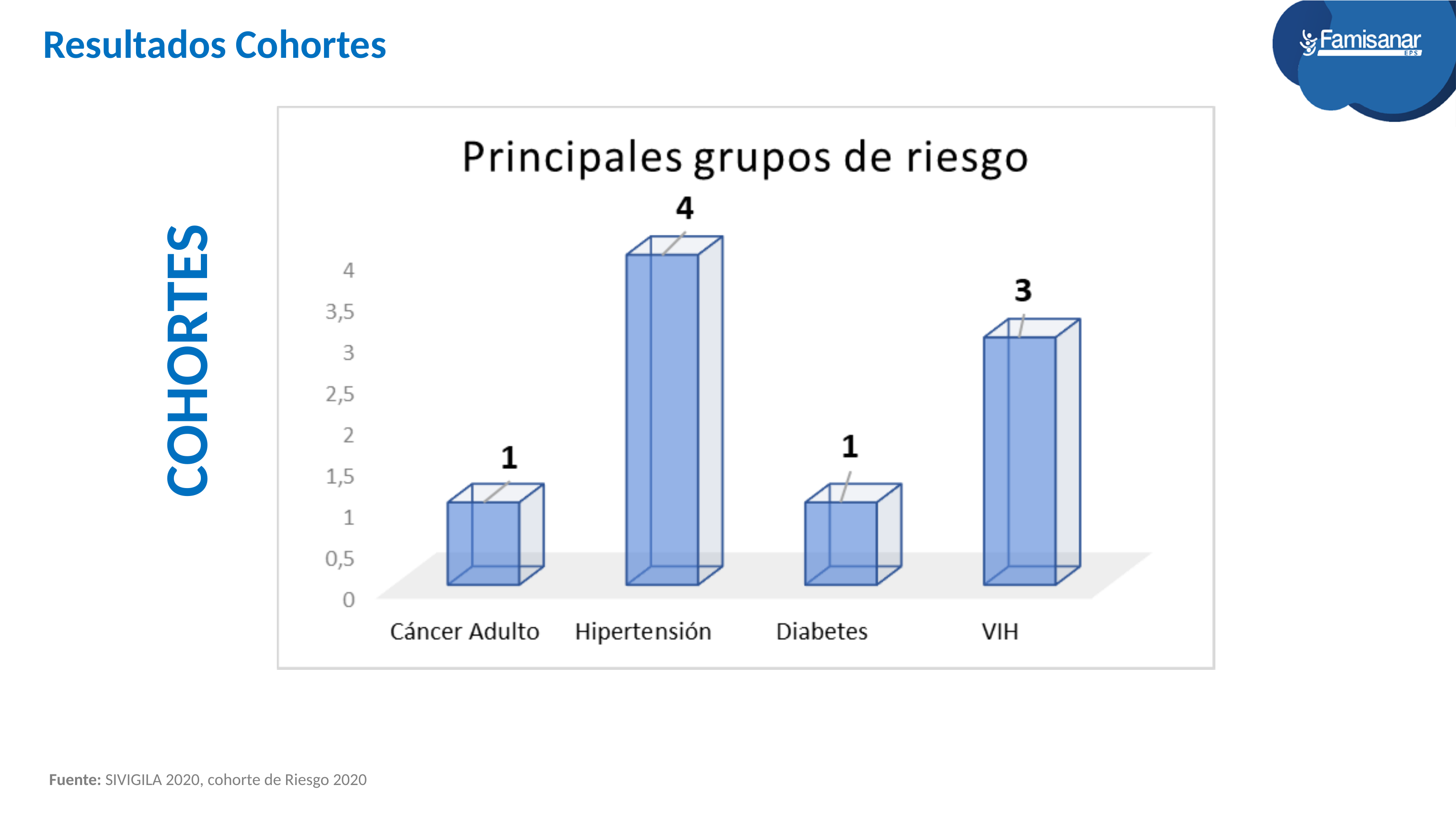
Is the value for Hipertensión greater or less than 3,5? greater How many categories are shown on the x axis? 4 What is the value for Cáncer Adulto? 1 What is the value for VIH? 3 What is the title of the chart? Principales grupos de riesgo Which is larger, the value for VIH or the value for Cáncer Adulto? VIH What is the difference between the values for VIH and Diabetes? 2 What kind of chart is shown? bar chart What is the difference between the values for Hipertensión and VIH? 1 Which category has the highest value? Hipertensión What is the value for Hipertensión? 4 What is the value for Diabetes? 1